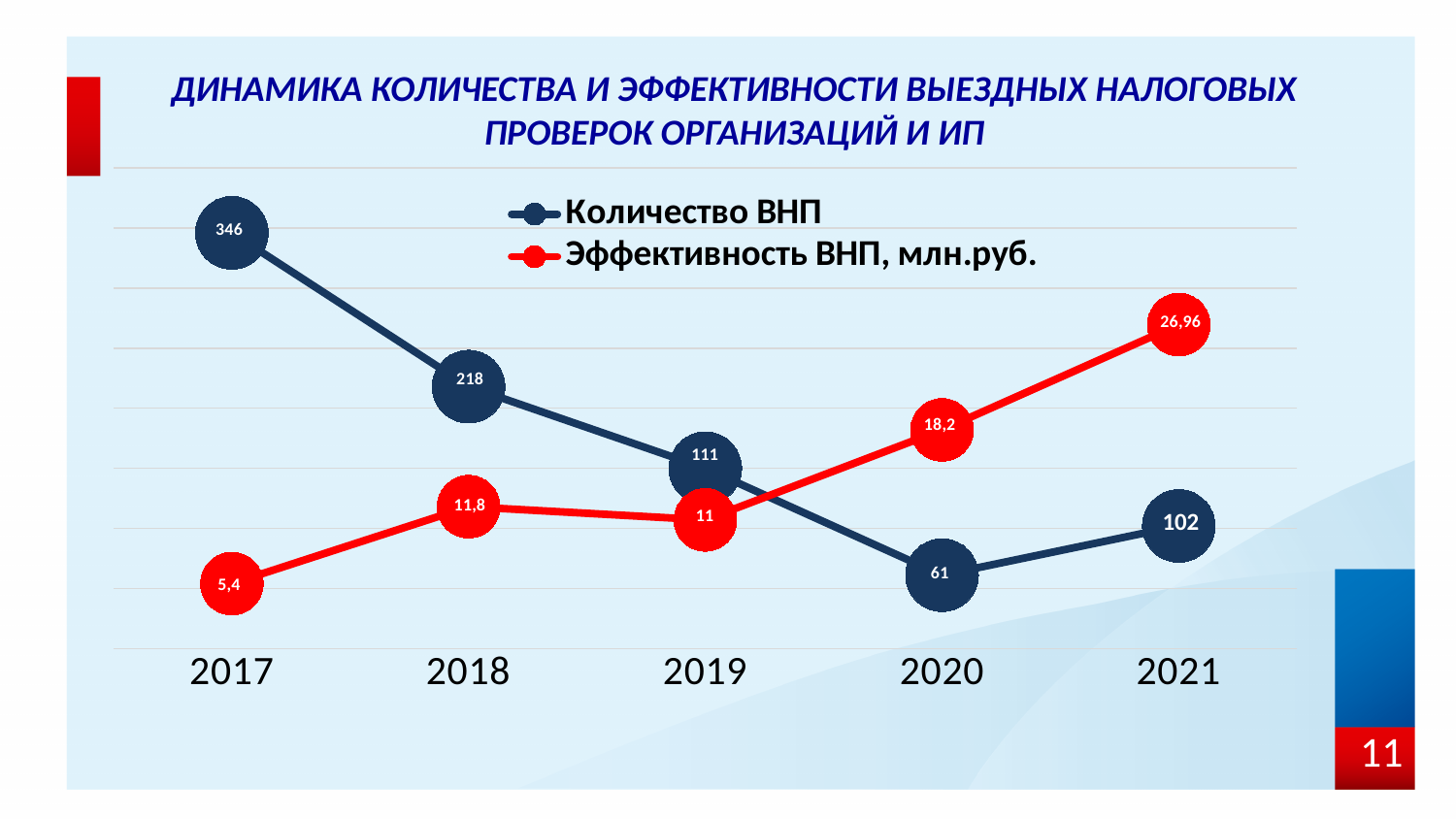
What is the value of Эффективность ВНП, млн.руб. in 2019? 11 Which year has a larger Эффективность ВНП, млн.руб.: 2018 or 2020? 2020 What is the value of Количество ВНП in 2020? 61 How many series does the legend list? 2 What kind of chart is shown on the slide? Line chart In which year is Количество ВНП the highest? 2017 What is the value of Эффективность ВНП, млн.руб. in 2021? 26,96 In which year is Эффективность ВНП, млн.руб. the lowest? 2017 What is the difference between Количество ВНП in 2017 and in 2018? 128 Does Эффективность ВНП, млн.руб. generally rise or fall from 2017 to 2021? Rise How many years are shown on the x axis? 5 What is the value of Количество ВНП in 2017? 346